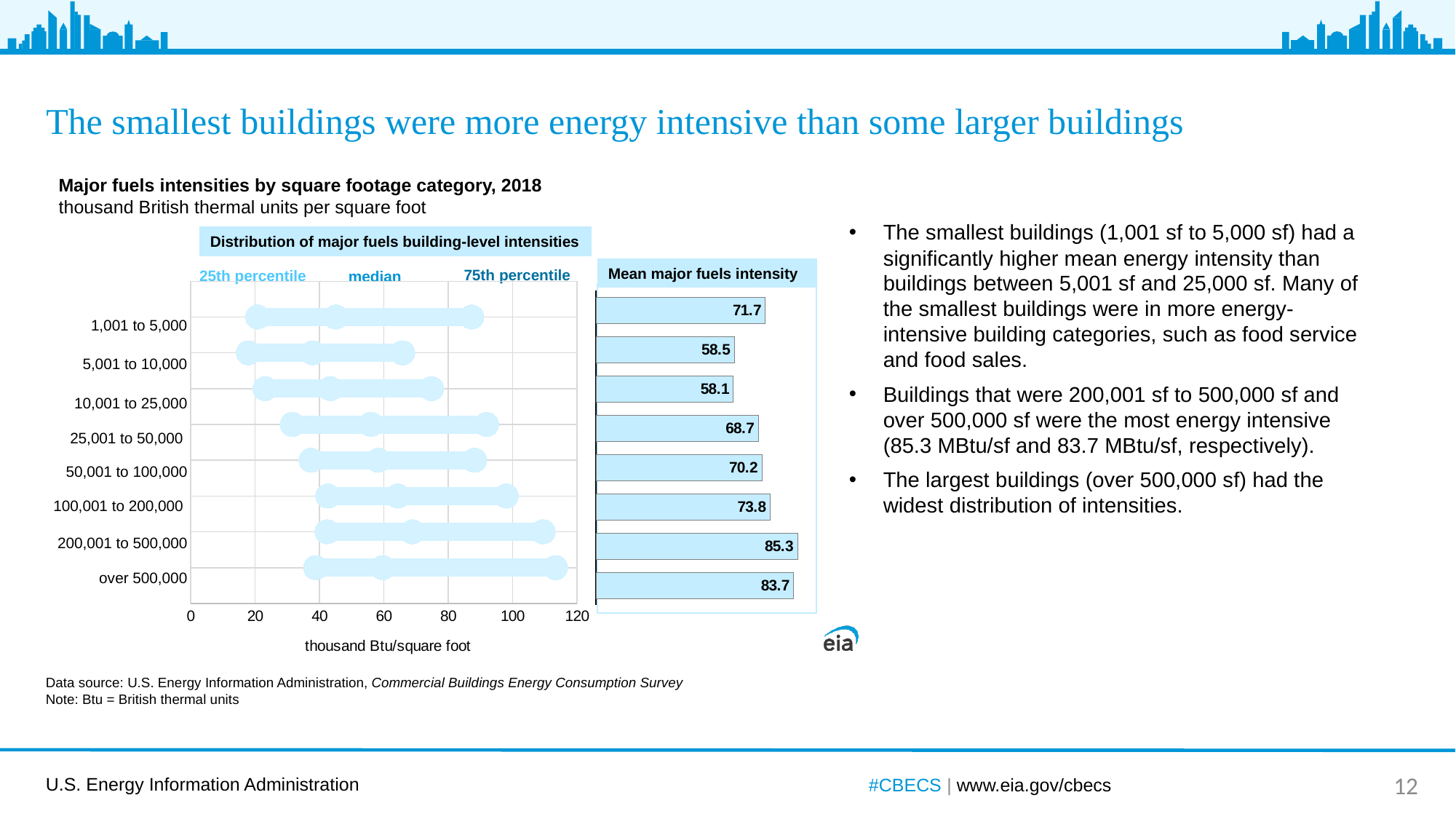
In the Mean major fuels intensity chart, what is the value for buildings over 500,000 square feet? 83.7 In the Distribution of major fuels building-level intensities chart, is the 75th percentile value for buildings over 500,000 square feet greater or less than 100? greater What kind of chart is the Mean major fuels intensity chart? bar chart In the Mean major fuels intensity chart, which square footage category has the highest mean intensity? 200,001 to 500,000 In the Mean major fuels intensity chart, what is the difference between the values for 200,001 to 500,000 and 10,001 to 25,000? 27.2 In the Mean major fuels intensity chart, which square footage category has the lowest mean intensity? 10,001 to 25,000 In the Mean major fuels intensity chart, what is the mean intensity for buildings of 1,001 to 5,000 square feet? 71.7 How many square footage categories are shown in the Distribution of major fuels building-level intensities chart? 8 In the Mean major fuels intensity chart, what is the value for the 200,001 to 500,000 category? 85.3 In the Mean major fuels intensity chart, which is larger: the value for 1,001 to 5,000 or the value for 5,001 to 10,000? 1,001 to 5,000 How many series does the legend of the Distribution of major fuels building-level intensities chart list? 3